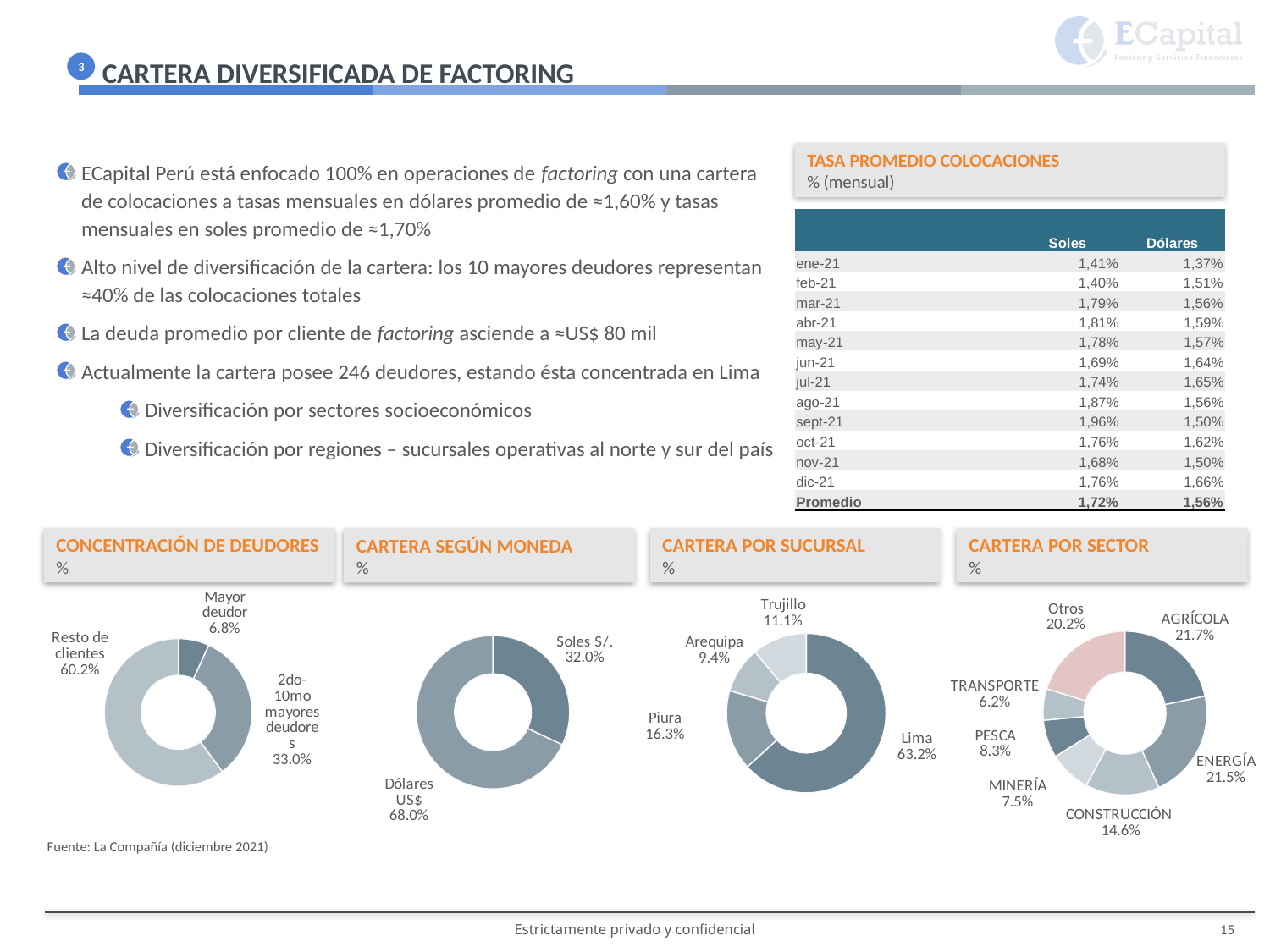
In the 'Cartera por Sector' chart, which sector has the smallest share? Transporte In the 'Cartera por Sector' chart, which is larger: Pesca or Minería? Pesca How many branches are shown in the 'Cartera por Sucursal' chart? 4 In the 'Concentración de Deudores' chart, what is the combined share of the Mayor deudor and the 2do-10mo mayores deudores? 39.8% What type of chart is used for 'Cartera según Moneda'? Donut (pie) chart How many sectors are shown in the 'Cartera por Sector' chart? 7 In the 'Cartera por Sucursal' chart, which branch has the largest share? Lima In the 'Cartera por Sucursal' chart, what percentage corresponds to Piura? 16.3% In the 'Cartera según Moneda' chart, what share of the portfolio is in Dólares US$? 68.0% In the 'Cartera por Sucursal' chart, what is the difference in percentage points between Lima and Piura? 46.9 In the 'Cartera por Sector' chart, what percentage corresponds to Construcción? 14.6% In the 'Concentración de Deudores' chart, which category has the largest share? Resto de clientes